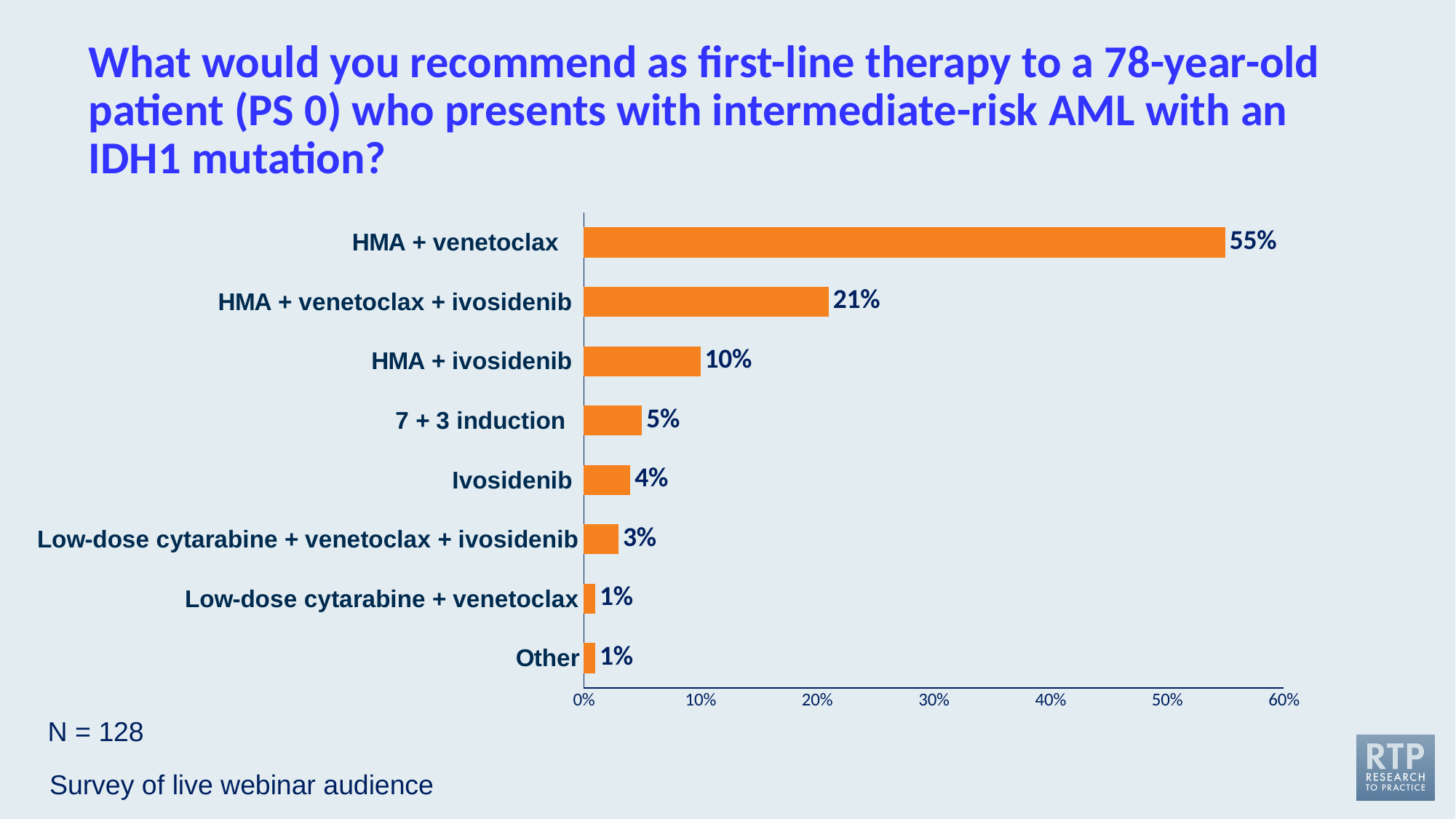
What is the difference in percentage points between HMA + ivosidenib and Ivosidenib? 6 What is the difference in percentage points between HMA + venetoclax and HMA + venetoclax + ivosidenib? 34 Which is larger, the value for HMA + ivosidenib or the value for 7 + 3 induction? HMA + ivosidenib Which option received the highest percentage of responses? HMA + venetoclax What is the N (number of respondents) stated on the slide? 128 What is the value for HMA + venetoclax + ivosidenib? 21% What percentage of respondents chose HMA + venetoclax? 55% Is the value for HMA + venetoclax greater or less than 50%? greater How many response options are shown on the chart? 8 What kind of chart is shown on the slide? Bar chart What percentage of respondents chose 7 + 3 induction? 5% What is the value for Low-dose cytarabine + venetoclax + ivosidenib? 3%